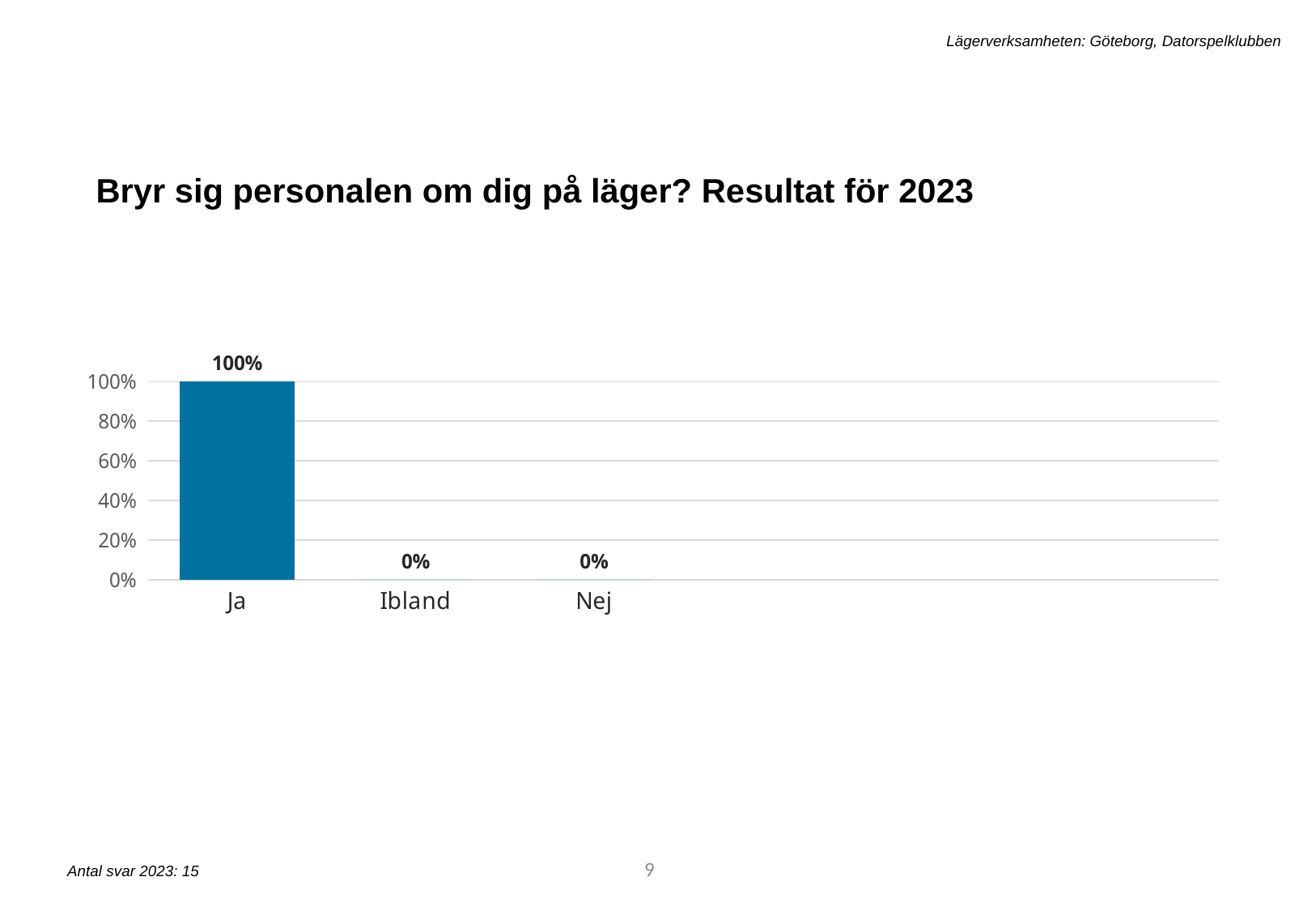
What is the value for Nej? 0% What is the difference between the values for Ja and Nej? 100% Which category has the highest value? Ja What is the value for Ja? 100% How many categories are shown on the x axis? 3 Which is larger, the value for Ja or the value for Ibland? Ja What is the title of the slide containing the chart? Bryr sig personalen om dig på läger? Resultat för 2023 What is the highest value shown on the y axis? 100% What kind of chart is shown on the slide? bar chart What is the value for Ibland? 0% Do the values rise or fall from Ja to Nej along the x axis? fall Is the value for Ja greater or less than 80%? greater